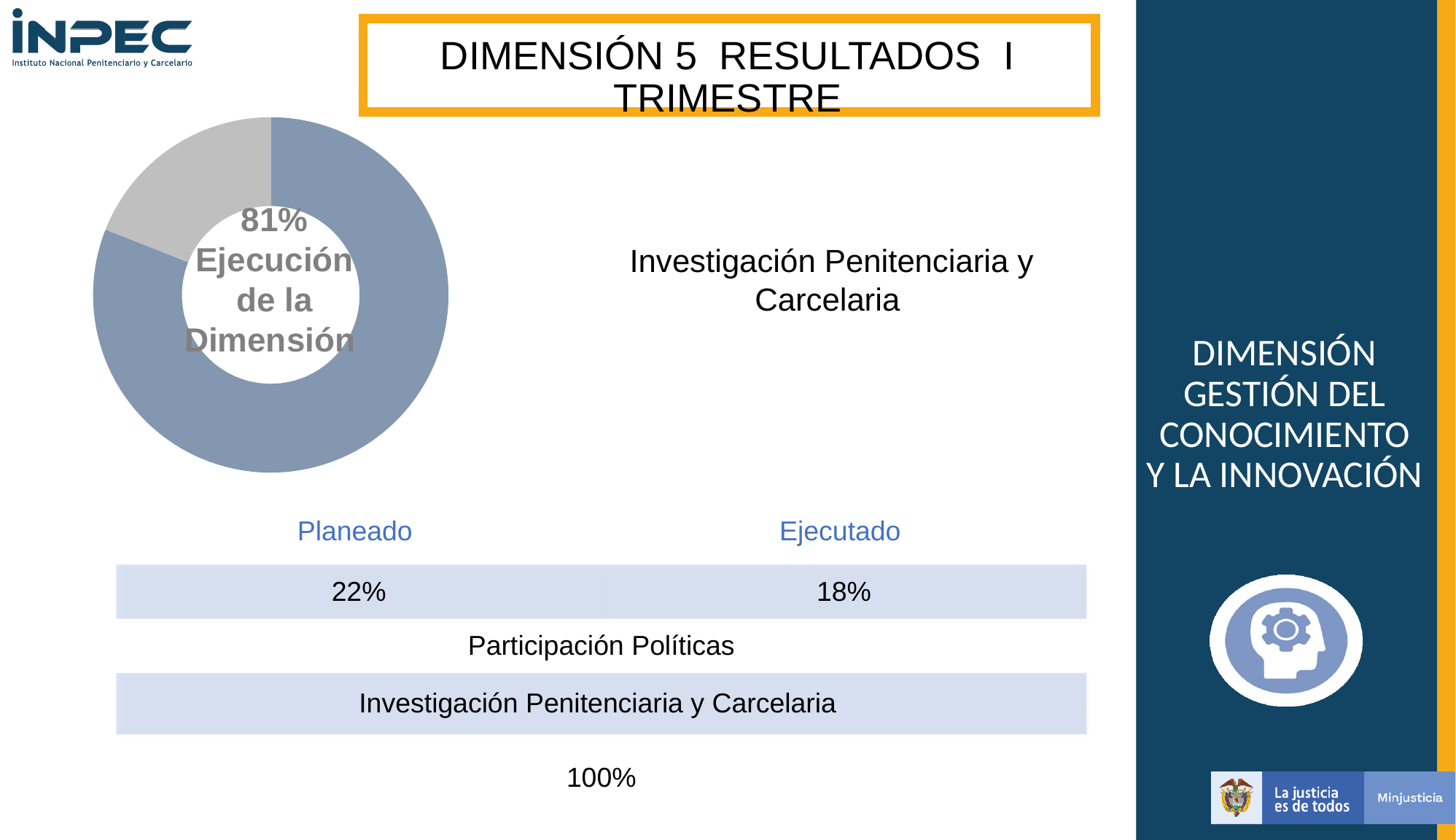
What percentage is printed in the centre of the donut chart? 81% What kind of chart is shown on the left of the slide? Pie chart (donut) What share of the donut chart does the grey slice represent? 19% What colour is the slice representing the executed portion of the dimension in the donut chart? Blue Is the blue slice of the donut chart more or less than half of the chart? More Which slice of the donut chart is larger, the blue one or the grey one? The blue one What does the 81% in the donut chart represent, according to its label? Ejecución de la Dimensión What share of the donut chart does the blue slice represent? 81% How many slices does the donut chart have? 2